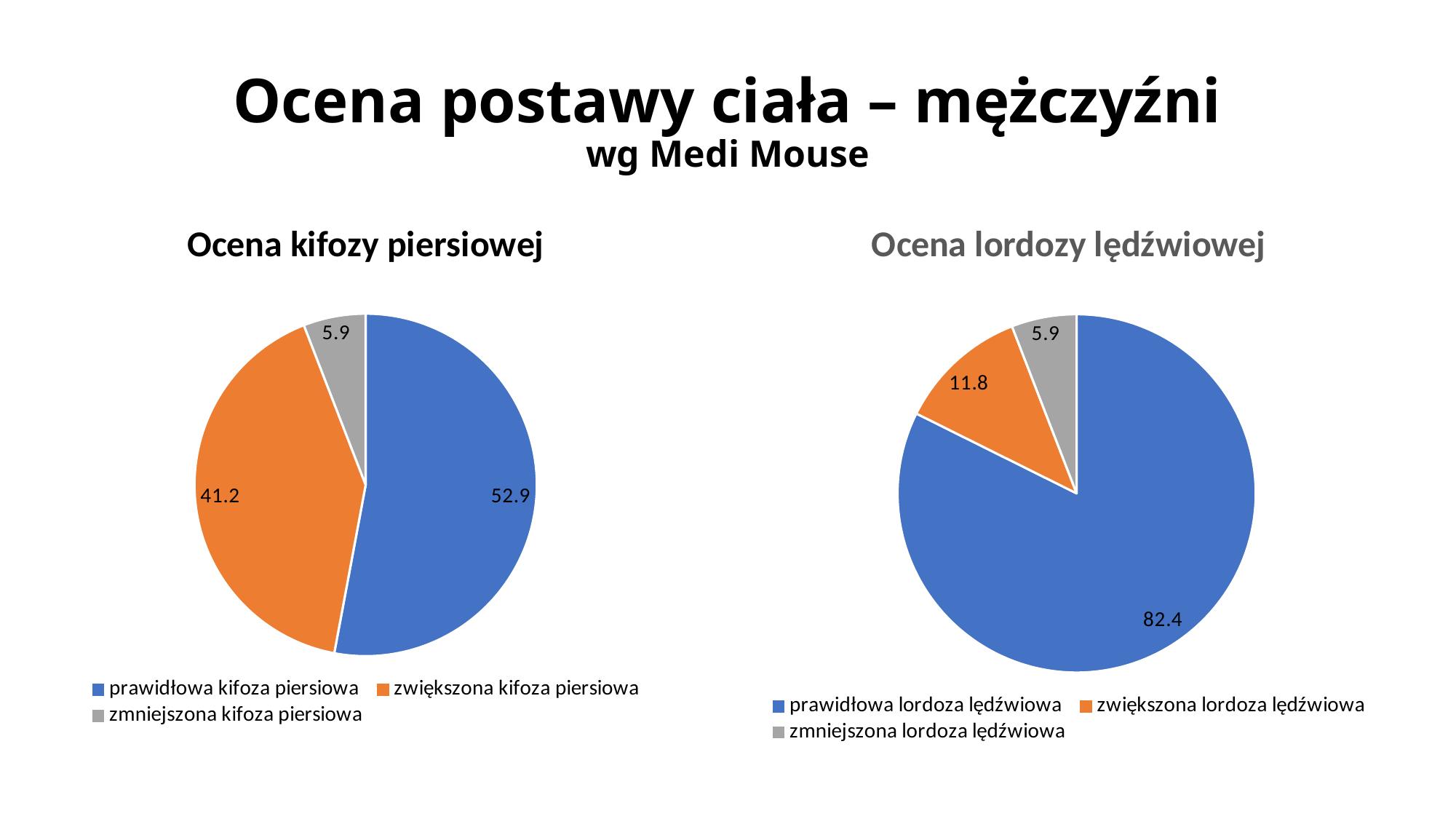
In the 'Ocena kifozy piersiowej' chart, what is the value for 'zwiększona kifoza piersiowa'? 41.2 In the 'Ocena kifozy piersiowej' chart, what is the value for 'prawidłowa kifoza piersiowa'? 52.9 In the 'Ocena kifozy piersiowej' chart, what colour is the slice for 'zmniejszona kifoza piersiowa'? Grey Which is larger: the value for 'prawidłowa kifoza piersiowa' in the left chart or the value for 'prawidłowa lordoza lędźwiowa' in the right chart? prawidłowa lordoza lędźwiowa In the 'Ocena lordozy lędźwiowej' chart, what is the value for 'zwiększona lordoza lędźwiowa'? 11.8 What type of chart is 'Ocena kifozy piersiowej'? Pie chart In the 'Ocena kifozy piersiowej' chart, which category has the largest slice? prawidłowa kifoza piersiowa In the 'Ocena kifozy piersiowej' chart, what is the difference between the values for 'prawidłowa kifoza piersiowa' and 'zwiększona kifoza piersiowa'? 11.7 In the 'Ocena lordozy lędźwiowej' chart, which category has the smallest slice? zmniejszona lordoza lędźwiowa In the 'Ocena lordozy lędźwiowej' chart, what is the value for 'prawidłowa lordoza lędźwiowa'? 82.4 How many slices does the 'Ocena lordozy lędźwiowej' chart have? 3 In the 'Ocena lordozy lędźwiowej' chart, what is the difference between the values for 'zwiększona lordoza lędźwiowa' and 'zmniejszona lordoza lędźwiowa'? 5.9